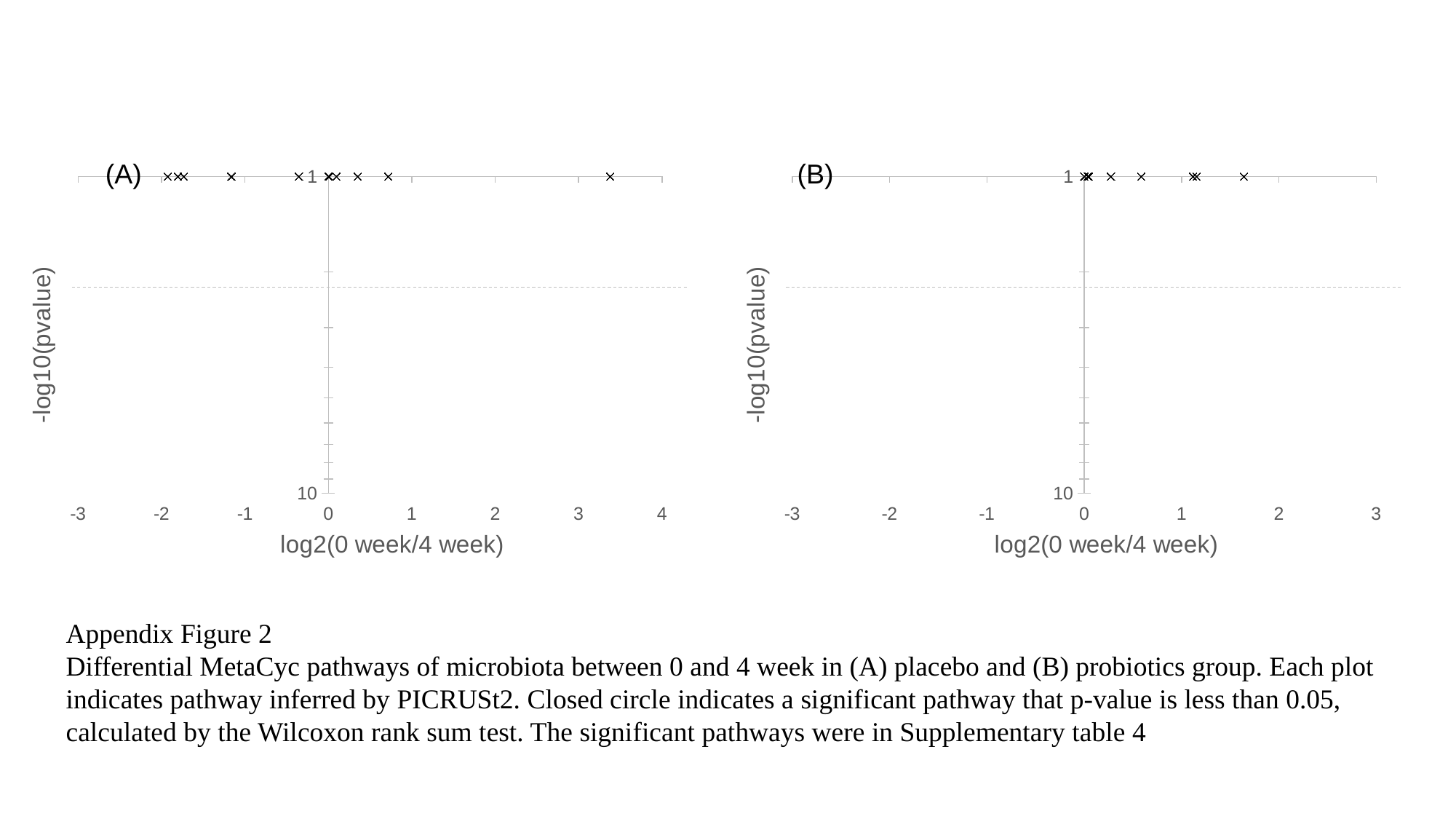
In panel (A), are the -log10(pvalue) values of the plotted points greater or less than 10? less In panel (A), is the x value of the leftmost point greater or less than -1? less What is the x-axis title of panel (A)? log2(0 week/4 week) What is the y-axis title of panel (B)? -log10(pvalue) What kind of chart is panel (B)? scatter chart In panel (A), is the x value of the rightmost point greater or less than 3? greater What kind of chart is panel (A)? scatter chart Which panel, (A) or (B), has a point that lies further to the left on the x axis? (A) Which panel, (A) or (B), has a point that lies further to the right on the x axis? (A)